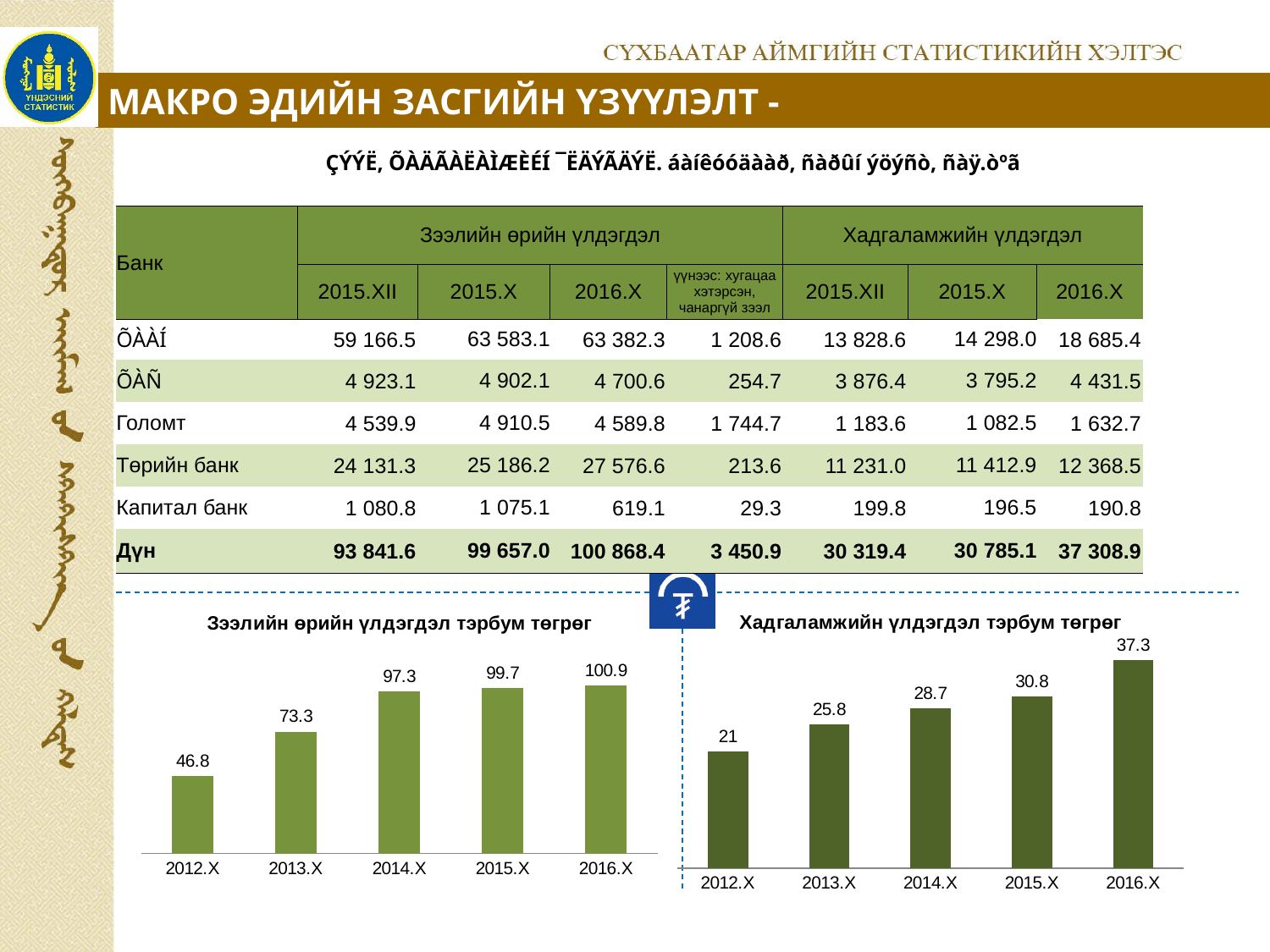
In the chart titled "Хадгаламжийн үлдэгдэл тэрбум төгрөг", what is the value for 2012.X? 21 In the chart titled "Зээлийн өрийн үлдэгдэл тэрбум төгрөг", which year has the highest value? 2016.X How many bars are shown in the chart titled "Зээлийн өрийн үлдэгдэл тэрбум төгрөг"? 5 In the chart titled "Хадгаламжийн үлдэгдэл тэрбум төгрөг", which year has the lowest value? 2012.X In the chart titled "Зээлийн өрийн үлдэгдэл тэрбум төгрөг", do the values rise or fall from 2012.X to 2016.X? Rise In the chart titled "Хадгаламжийн үлдэгдэл тэрбум төгрөг", what is the difference between the values for 2016.X and 2015.X? 6.5 What kind of chart is the chart titled "Хадгаламжийн үлдэгдэл тэрбум төгрөг"? Bar chart In the chart titled "Хадгаламжийн үлдэгдэл тэрбум төгрөг", what is the value for 2015.X? 30.8 In the chart titled "Зээлийн өрийн үлдэгдэл тэрбум төгрөг", what is the difference between the values for 2013.X and 2012.X? 26.5 What is the title of the bar chart on the left side of the slide? Зээлийн өрийн үлдэгдэл тэрбум төгрөг In the chart titled "Зээлийн өрийн үлдэгдэл тэрбум төгрөг", what is the value for 2014.X? 97.3 In the chart titled "Хадгаламжийн үлдэгдэл тэрбум төгрөг", which is larger, the value for 2013.X or 2014.X? 2014.X